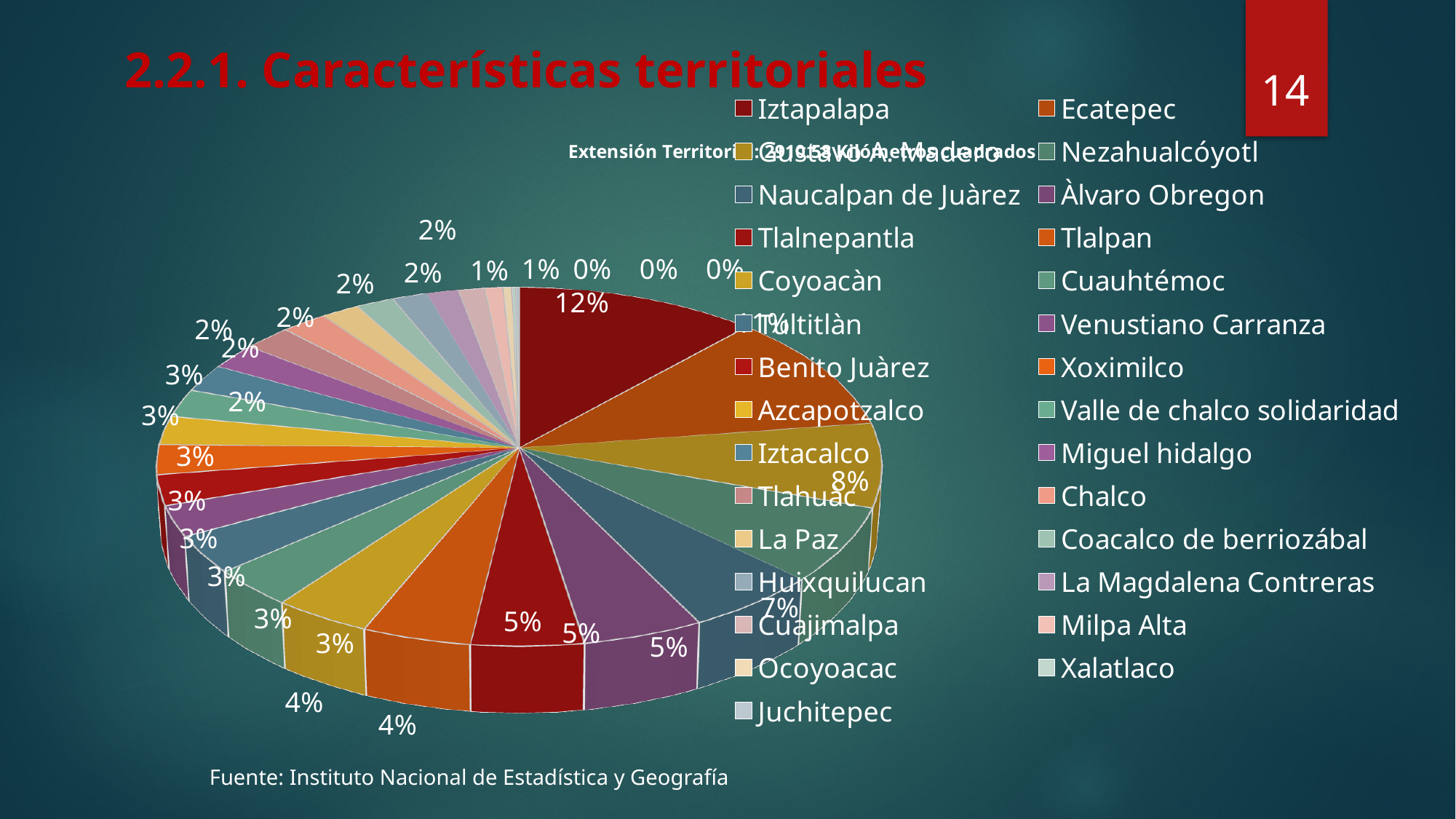
What percentage is shown for Gustavo A. Madero? 8% Which category has the largest slice in the pie chart? Iztapalapa What is the difference in percentage points between Iztapalapa and Gustavo A. Madero? 4 What kind of chart is shown on the slide? pie chart What is the smallest percentage value labelled on the pie chart? 0% How many entries does the legend of the pie chart list? 29 Which is larger, the share for Iztapalapa or the share for Gustavo A. Madero? Iztapalapa What is the difference in percentage points between Iztapalapa and Nezahualcóyotl? 5 What percentage is shown for Iztapalapa? 12% What percentage is shown for Nezahualcóyotl? 7% What source is cited below the chart? Instituto Nacional de Estadística y Geografía How many slices of the pie chart are labelled 0%? 3